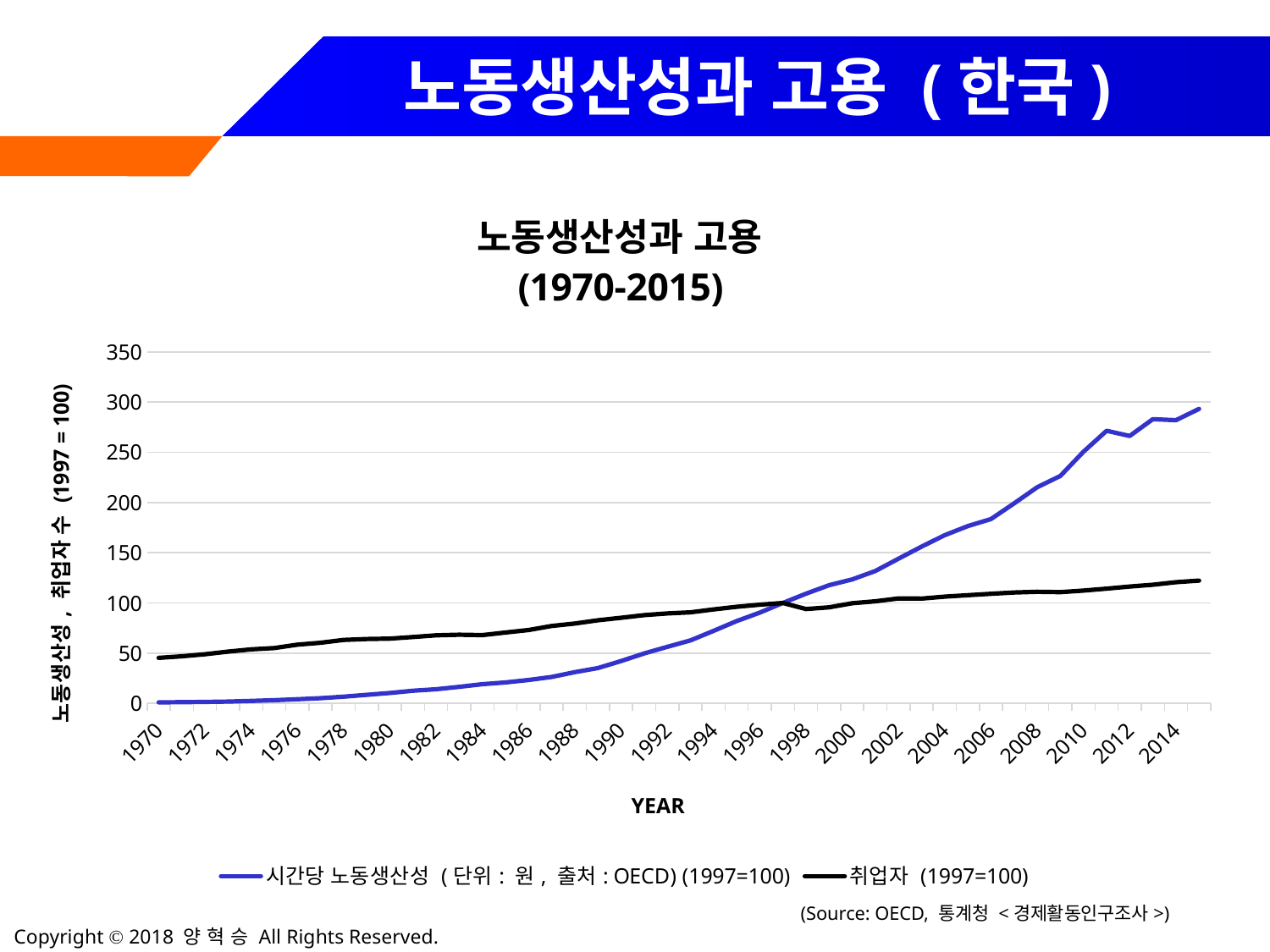
How many series does the legend list? 2 What is the title of the chart? 노동생산성과 고용 (1970-2015) Does the 취업자 line rise or fall overall from 1970 to 2015? rise Is the value for 시간당 노동생산성 in 1980 greater or less than 50? less Is the value for 시간당 노동생산성 in 2014 greater or less than 250? greater In 2010, which series has the higher value, 시간당 노동생산성 or 취업자? 시간당 노동생산성 What kind of chart is shown on the slide? line chart Does the 시간당 노동생산성 line rise or fall from 1970 to 2015? rise Is the value for 취업자 in 1970 greater or less than 100? less What is the label of the x axis? YEAR In 1990, which series has the higher value, 시간당 노동생산성 or 취업자? 취업자